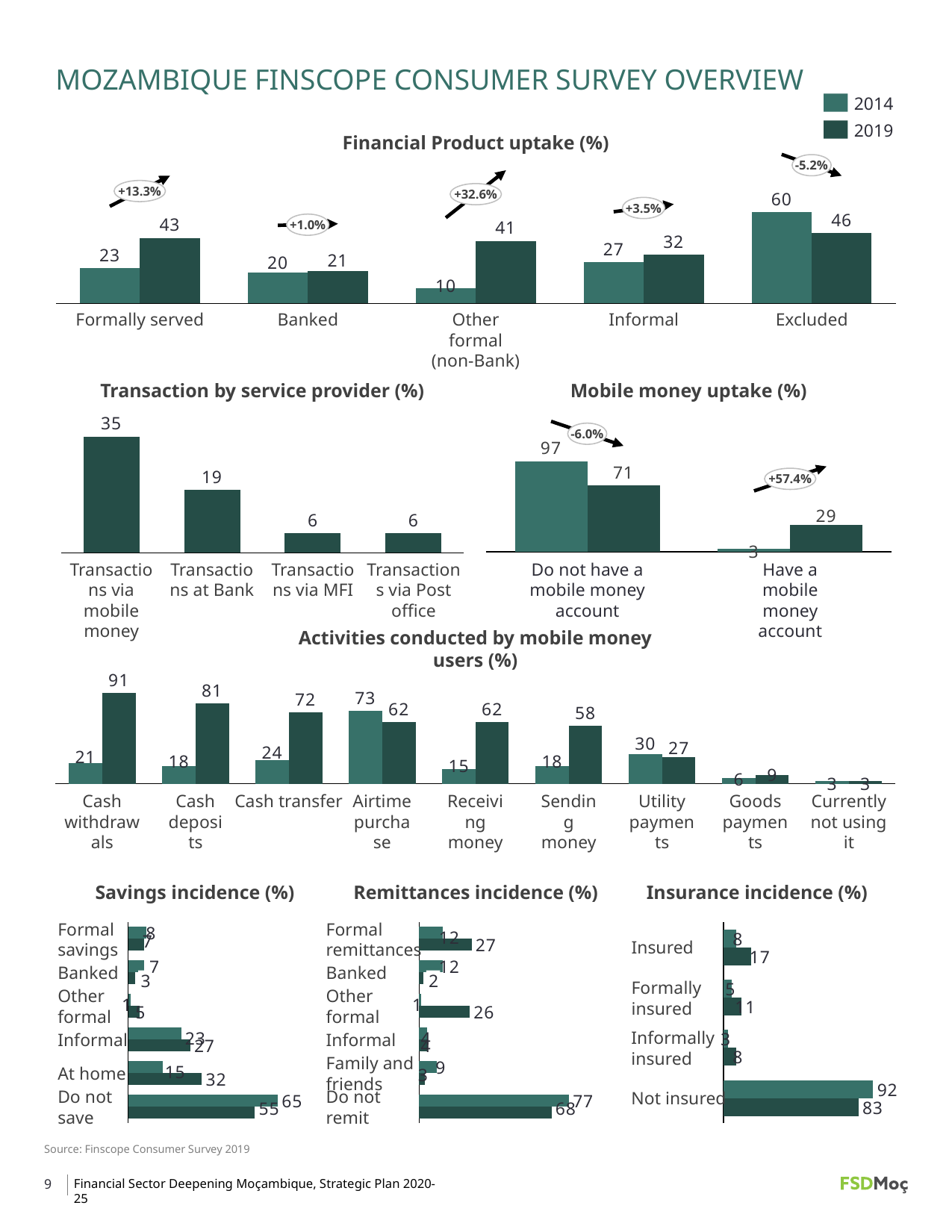
In the Activities conducted by mobile money users (%) chart, is the 2014 value for Airtime purchase larger or smaller than the 2019 value? larger In the Remittances incidence (%) chart, what is the 2014 value for Do not remit? 77 How many series does the legend at the top of the slide list? 2 In the Transaction by service provider (%) chart, how many categories are shown? 4 In the Transaction by service provider (%) chart, which category has the highest value? Transactions via mobile money In the Savings incidence (%) chart, what is the 2019 value for At home? 32 In the Mobile money uptake (%) chart, what is the 2019 value for Have a mobile money account? 29 In the Financial Product uptake (%) chart, what is the 2014 value for Excluded? 60 In the Financial Product uptake (%) chart, what is the 2019 value for Formally served? 43 In the Insurance incidence (%) chart, what is the difference between the 2014 and 2019 values for Not insured? 9 In the Activities conducted by mobile money users (%) chart, which activity has the highest 2019 value? Cash withdrawals In the Financial Product uptake (%) chart, what is the difference between the 2019 and 2014 values for Other formal (non-Bank)? 31